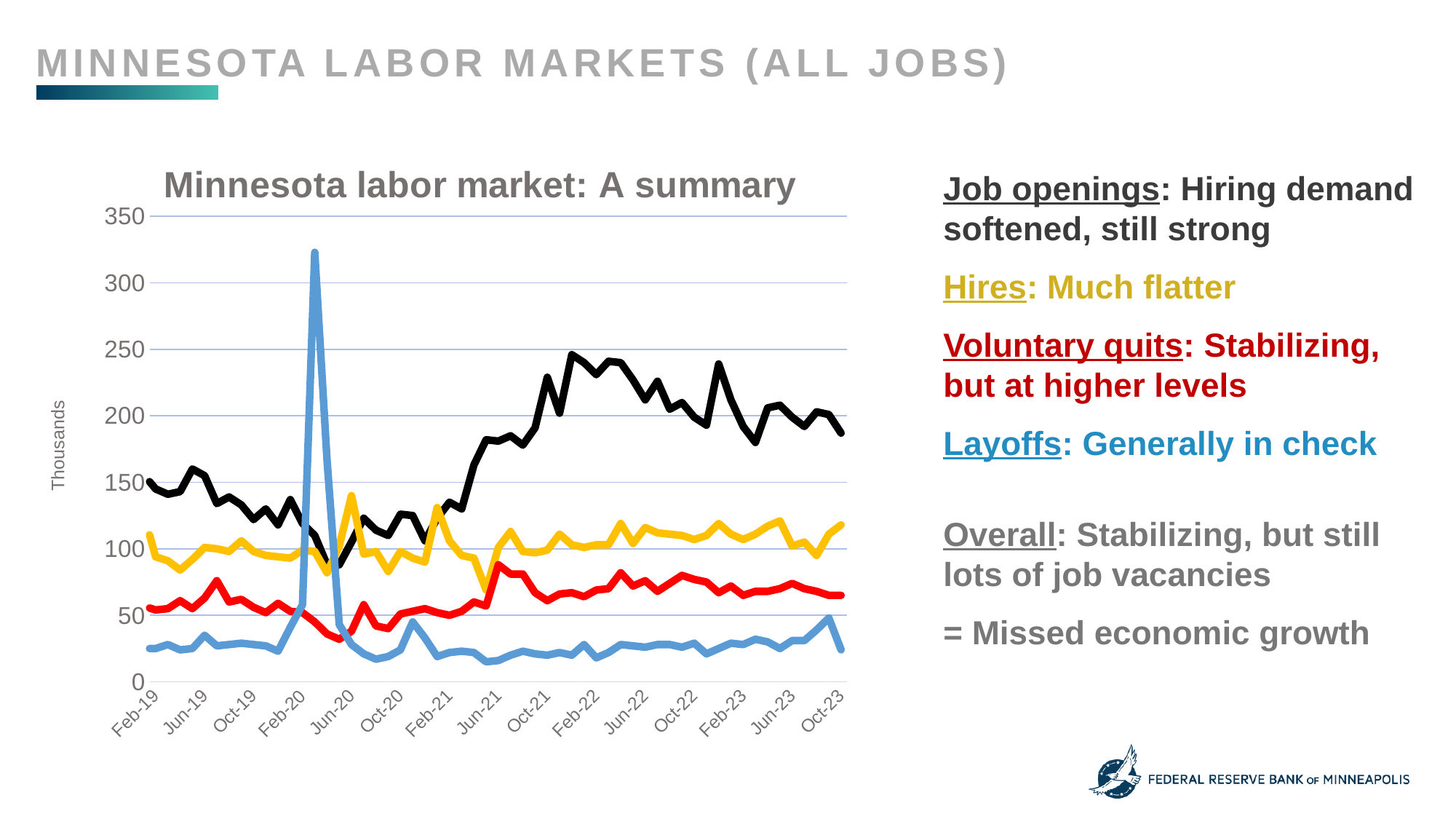
How many lines (series) are plotted on the chart? 4 Is the peak of the blue (layoffs) line greater or less than 300? greater Which line reaches the highest value anywhere on the chart? the blue line (layoffs) Is the value of the red (voluntary quits) line at Feb-19 greater or less than 100? less How many date labels are shown on the x axis? 15 What is the label on the vertical axis of the chart? Thousands Is the black (job openings) line higher at Feb-19 or at Oct-23? Oct-23 What is the title of the chart? Minnesota labor market: A summary Is the value of the black (job openings) line at Oct-23 greater or less than 150? greater At Oct-23, is the yellow (hires) line higher or lower than the red (voluntary quits) line? higher What type of chart is shown on the slide? line chart